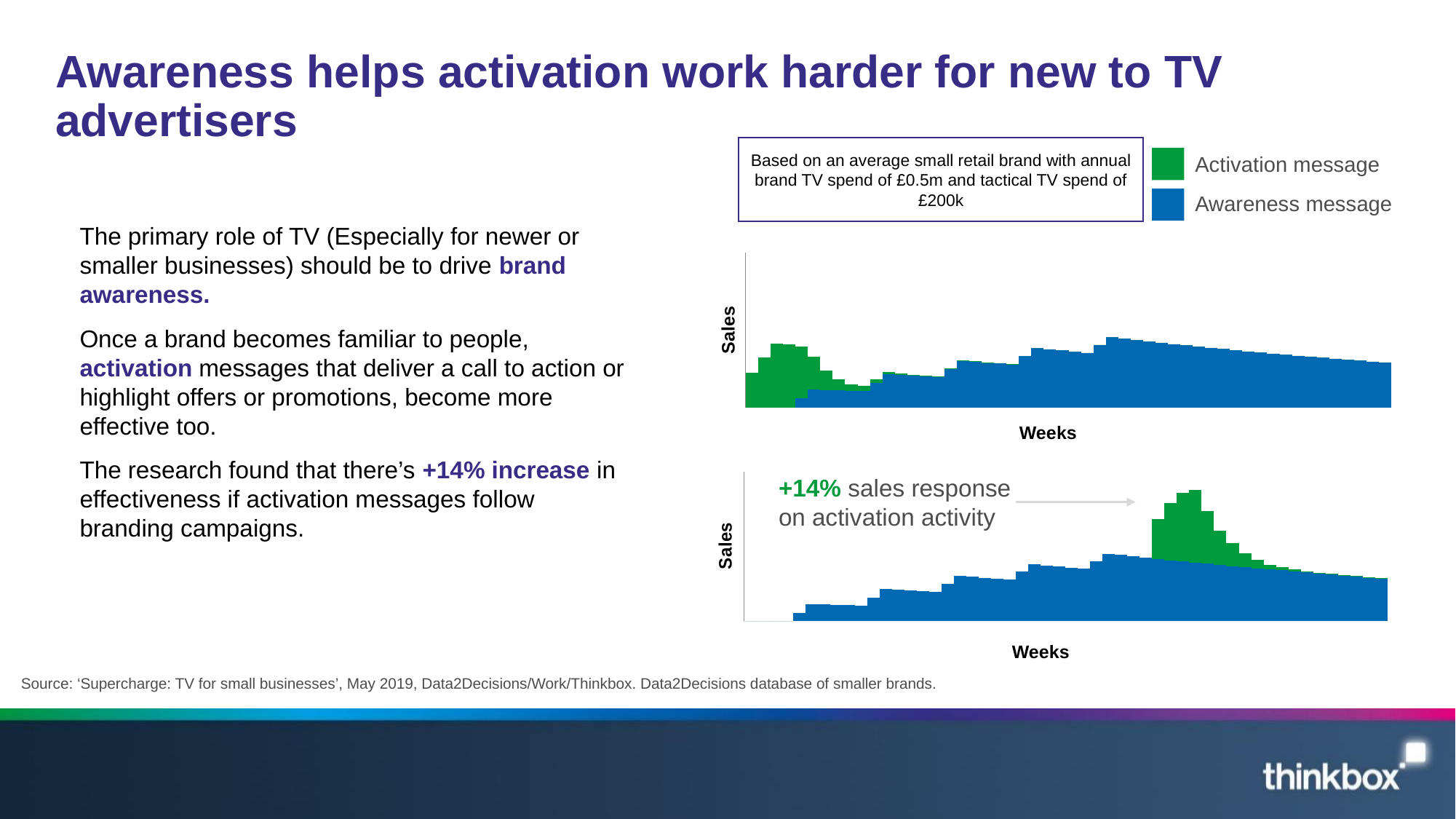
In the top chart, does the Awareness message series rise or fall from the first week to its peak around the middle of the weeks? rise What kind of chart is the bottom chart on the slide? bar chart In the bottom chart, does the Awareness message series rise or fall over the first half of the weeks? rise What kind of chart is the top chart on the slide? bar chart In the top chart, does the Activation message series rise or fall after its initial peak in the first weeks? fall Which colour represents the Activation message series? green What percentage sales response on activation activity is annotated on the bottom chart? +14% How many series does the legend list for the charts? 2 What are the two series named in the legend? Activation message and Awareness message